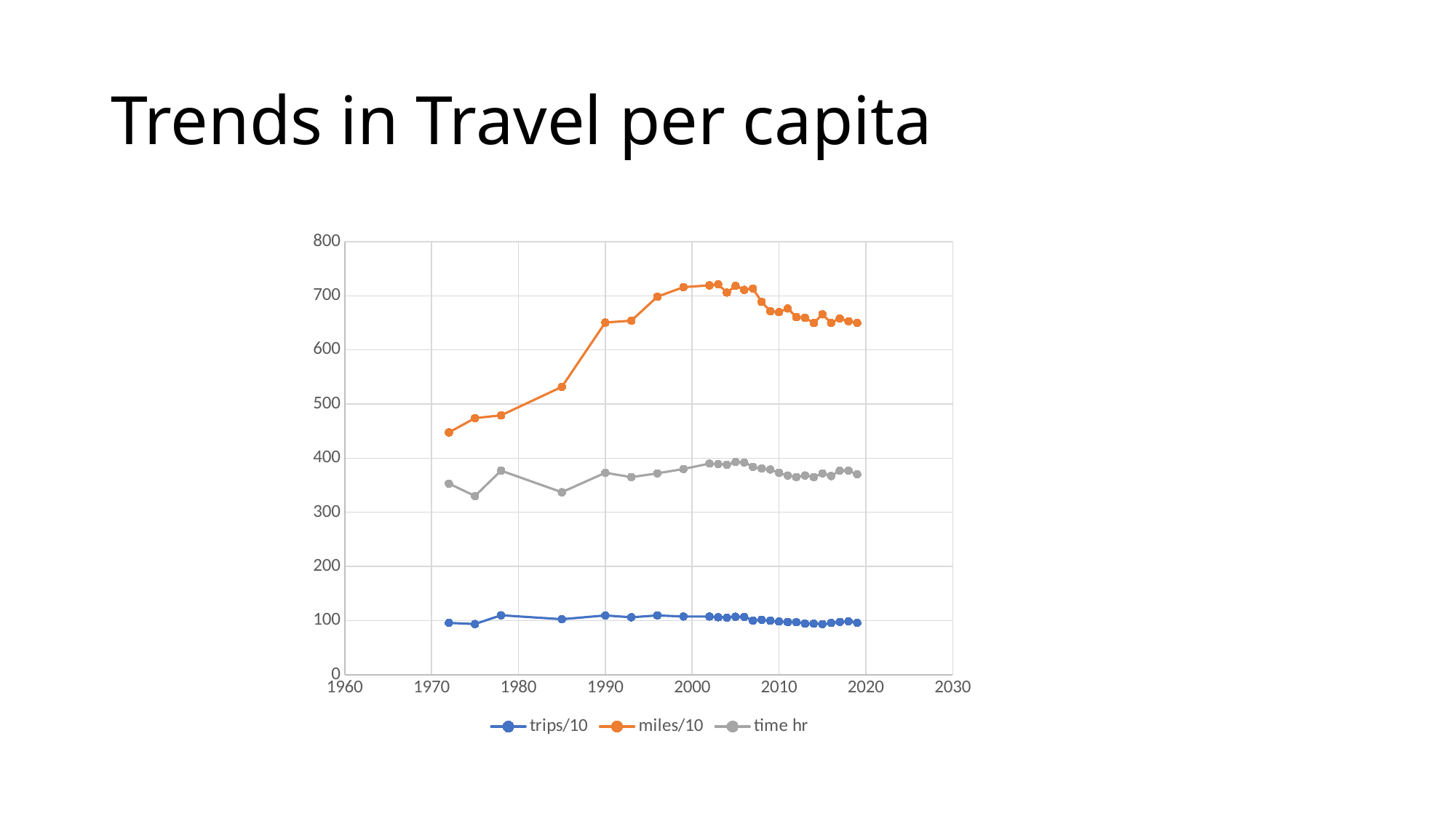
How many series does the legend list? 3 Is the value for time hr in 1985 greater or less than 400? less Is the value for time hr in 1972 greater or less than 300? greater Is the value for miles/10 in 1972 greater or less than 500? less Does the miles/10 series rise or fall between 1972 and 2000? rise Which series has the highest values across the chart? miles/10 What is the title of the slide's chart? Trends in Travel per capita Which series is plotted in orange? miles/10 What kind of chart is shown on the slide? line chart Which series has the lowest values across the chart? trips/10